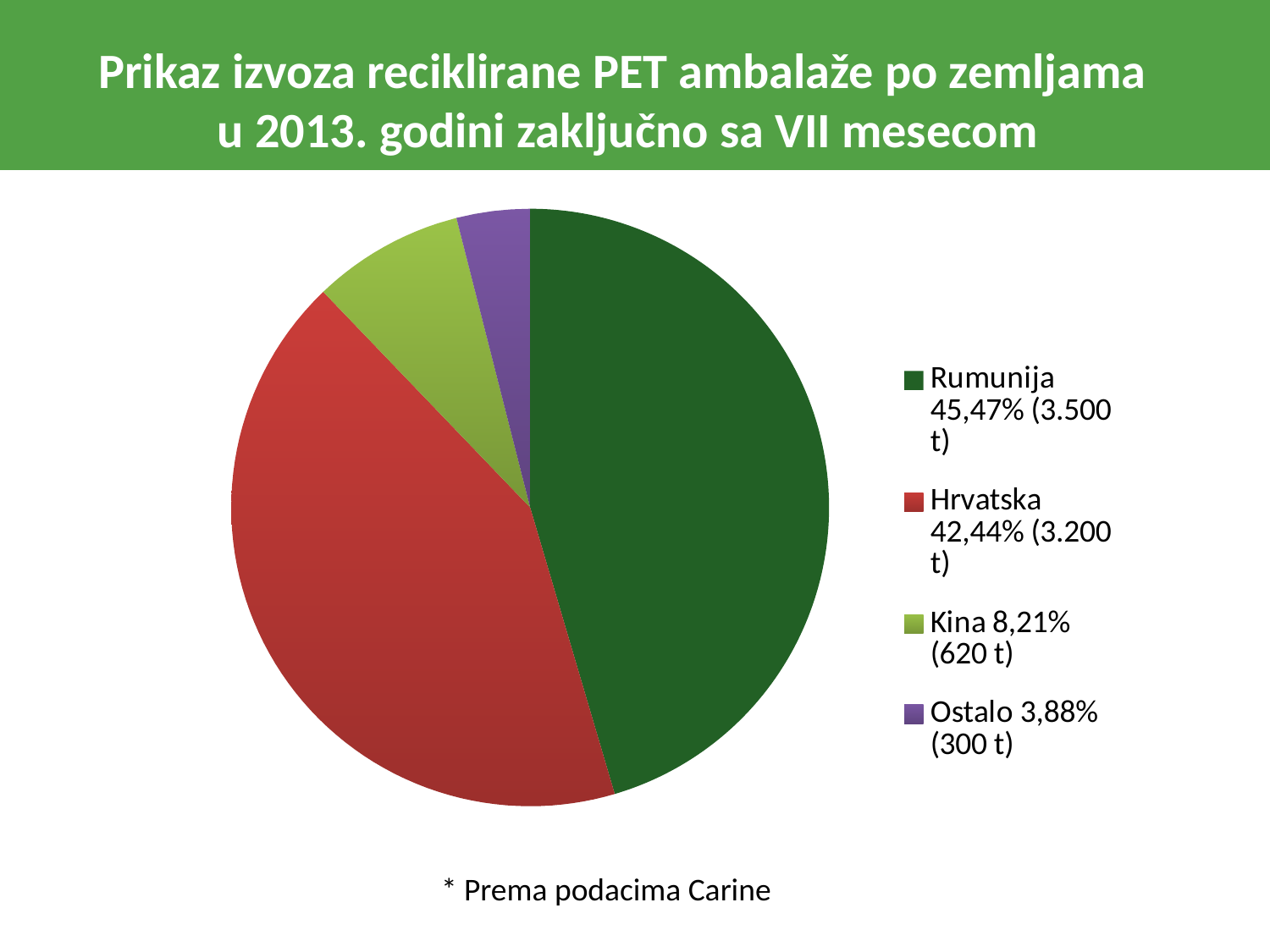
What share of the pie does Kina hold? 8,21% Which is larger, the slice for Kina or the slice for Ostalo? Kina How many slices does the pie chart have? 4 What kind of chart is shown on the slide? pie chart What share of the pie does Ostalo hold? 3,88% How many tonnes were exported to Kina according to the legend? 620 t Which category has the smallest slice of the pie? Ostalo What share of the pie does Rumunija hold? 45,47% How many tonnes were exported to Rumunija according to the legend? 3.500 t Which category has the largest slice of the pie? Rumunija What is the difference in tonnes between Rumunija and Hrvatska? 300 t